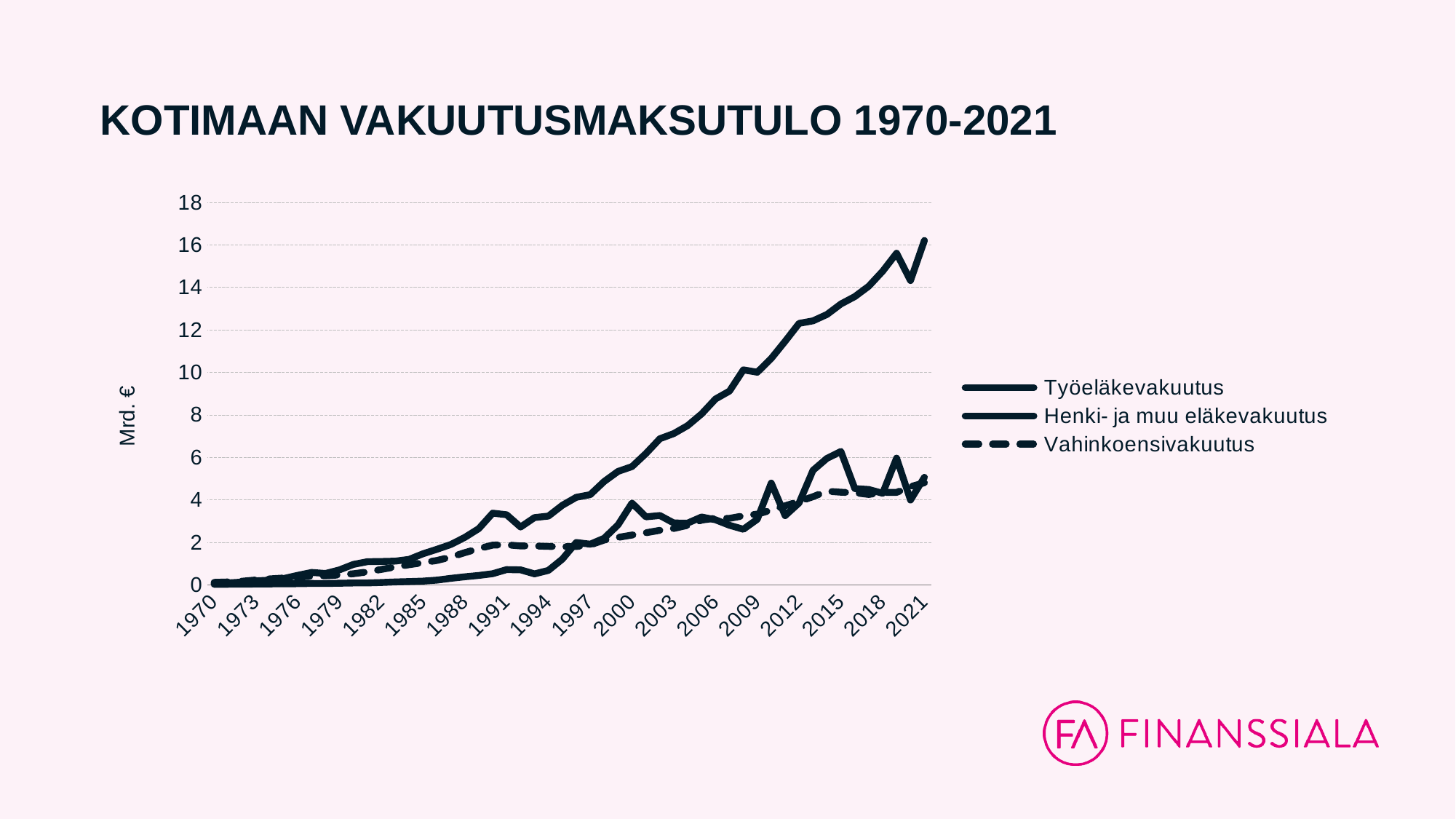
Is the value for Henki- ja muu eläkevakuutus in 1994 greater or less than 2? less How many series does the legend list? 3 What unit is shown on the y-axis label? Mrd. € In 2021, which is larger: Työeläkevakuutus or Vahinkoensivakuutus? Työeläkevakuutus Is the value for Työeläkevakuutus in 2021 greater or less than 14? greater Is the value for Vahinkoensivakuutus in 2021 greater or less than 8? less What kind of chart is shown on the slide? Line chart Does the Työeläkevakuutus series generally rise or fall from 1970 to 2021? Rise Which series reaches the highest value on the chart? Työeläkevakuutus What is the title of the chart? KOTIMAAN VAKUUTUSMAKSUTULO 1970-2021 How many year labels are shown on the x-axis? 18